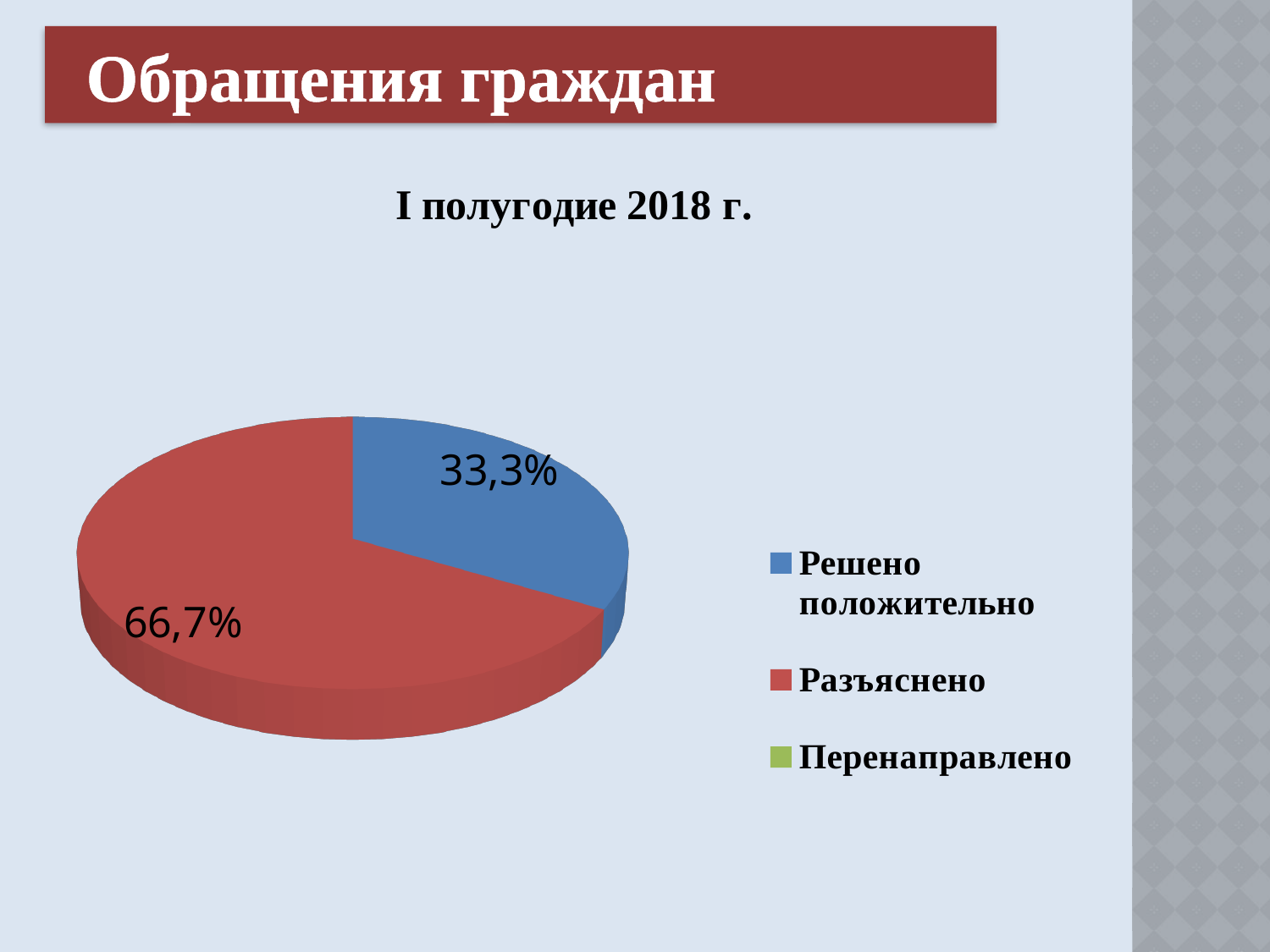
What share of the pie is labelled for Разъяснено? 66,7% What colour is the slice for Решено положительно? blue Which category has the largest slice of the pie? Разъяснено What type of chart is shown on the slide? pie chart What is the chart's title? I полугодие 2018 г. Which of the two labelled slices is smaller, Решено положительно or Разъяснено? Решено положительно Which is larger, the share for Разъяснено or the share for Решено положительно? Разъяснено How many slices with a printed percentage label are visible in the pie? 2 How many entries does the legend list? 3 What share of the pie is labelled for Решено положительно? 33,3% Which legend entry has no visible slice in the pie? Перенаправлено By how many percentage points does the share for Разъяснено exceed the share for Решено положительно? 33,4